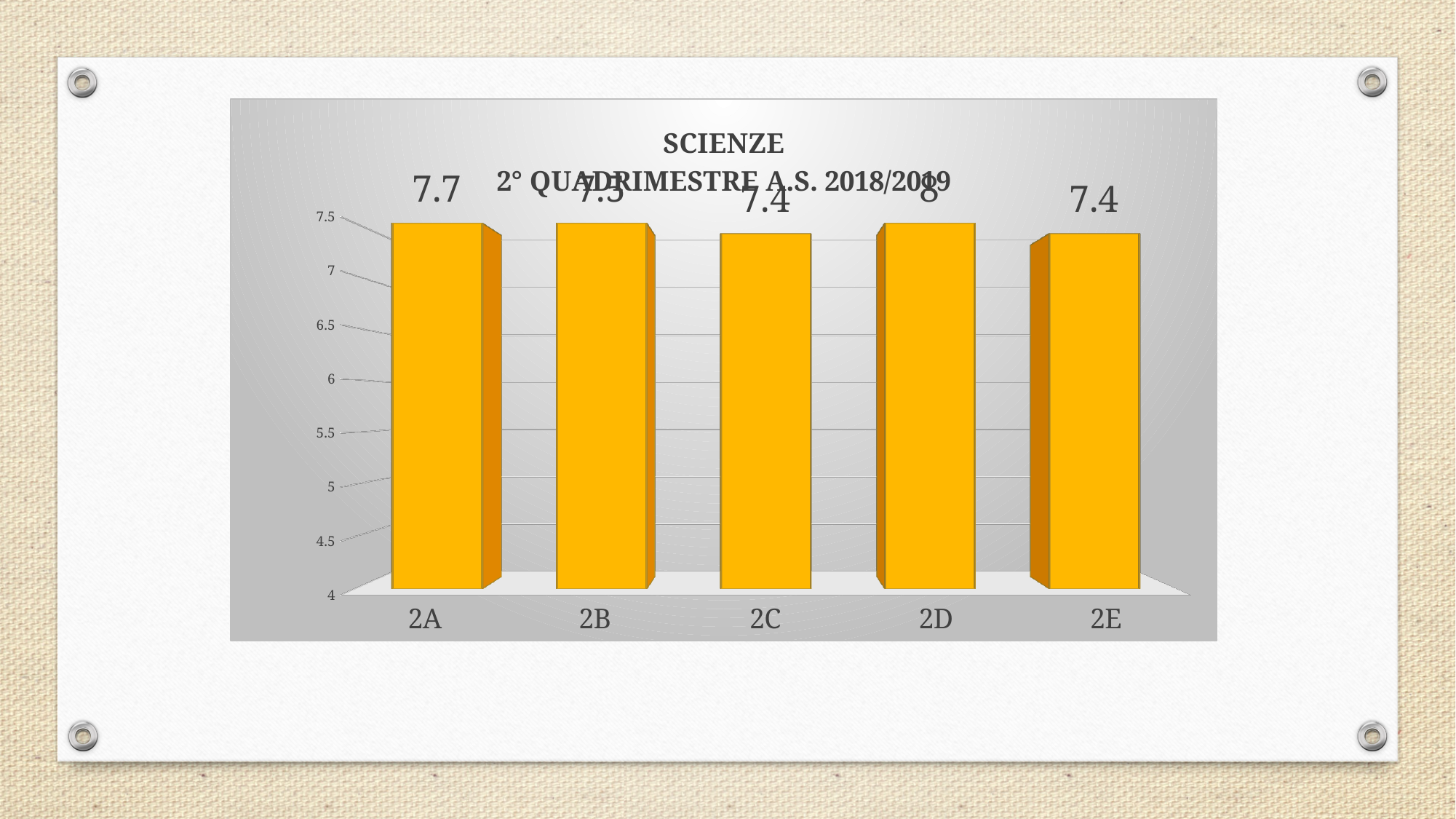
What is the difference between the values for 2A and 2B? 0.2 What is the value for 2A? 7.7 Is the value for 2E greater or less than 7? greater What subject is named in the chart title? SCIENZE What is the difference between the values for 2D and 2E? 0.6 Which is larger, the value for 2A or the value for 2C? 2A Which class has the highest value? 2D What is the value for 2D? 8 What is the value for 2B? 7.5 How many classes are shown on the x axis? 5 What is the value for 2C? 7.4 What kind of chart is shown on the slide? bar chart